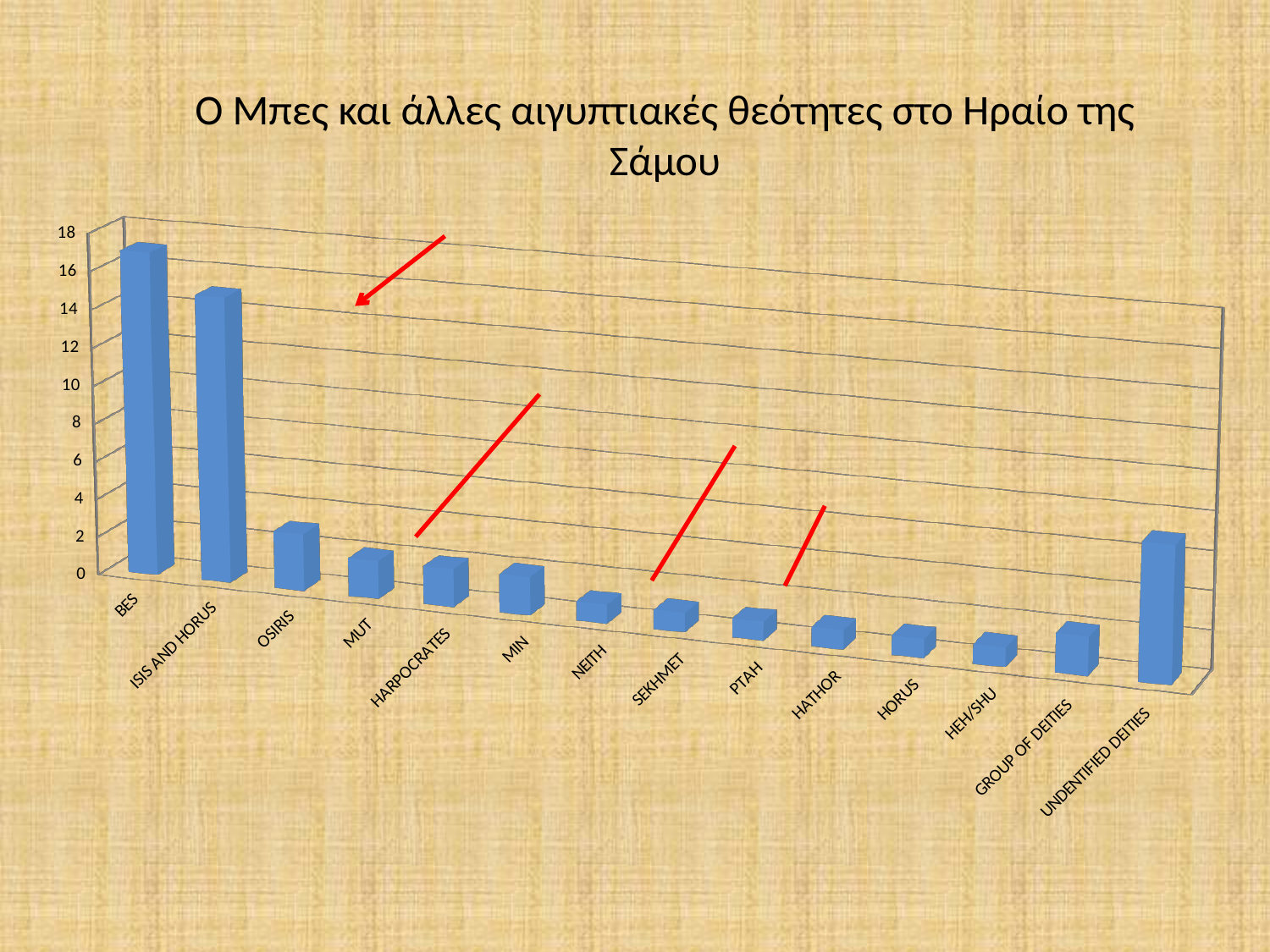
Which is larger, the value for ISIS AND HORUS or the value for MUT? ISIS AND HORUS What is the highest value shown on the vertical axis of the chart? 18 Is the value for BES greater or less than 10? greater Which category has the highest value in the chart? BES What is the title of the chart on the slide? Ο Μπες και άλλες αιγυπτιακές θεότητες στο Ηραίο της Σάμου Do the values generally rise or fall along the x axis from BES to HEH/SHU? fall What kind of chart is shown on the slide? bar chart Is the value for OSIRIS greater or less than 6? less Is the value for NEITH greater or less than 4? less How many categories are shown on the x axis of the chart? 14 Which is larger, the value for BES or the value for OSIRIS? BES